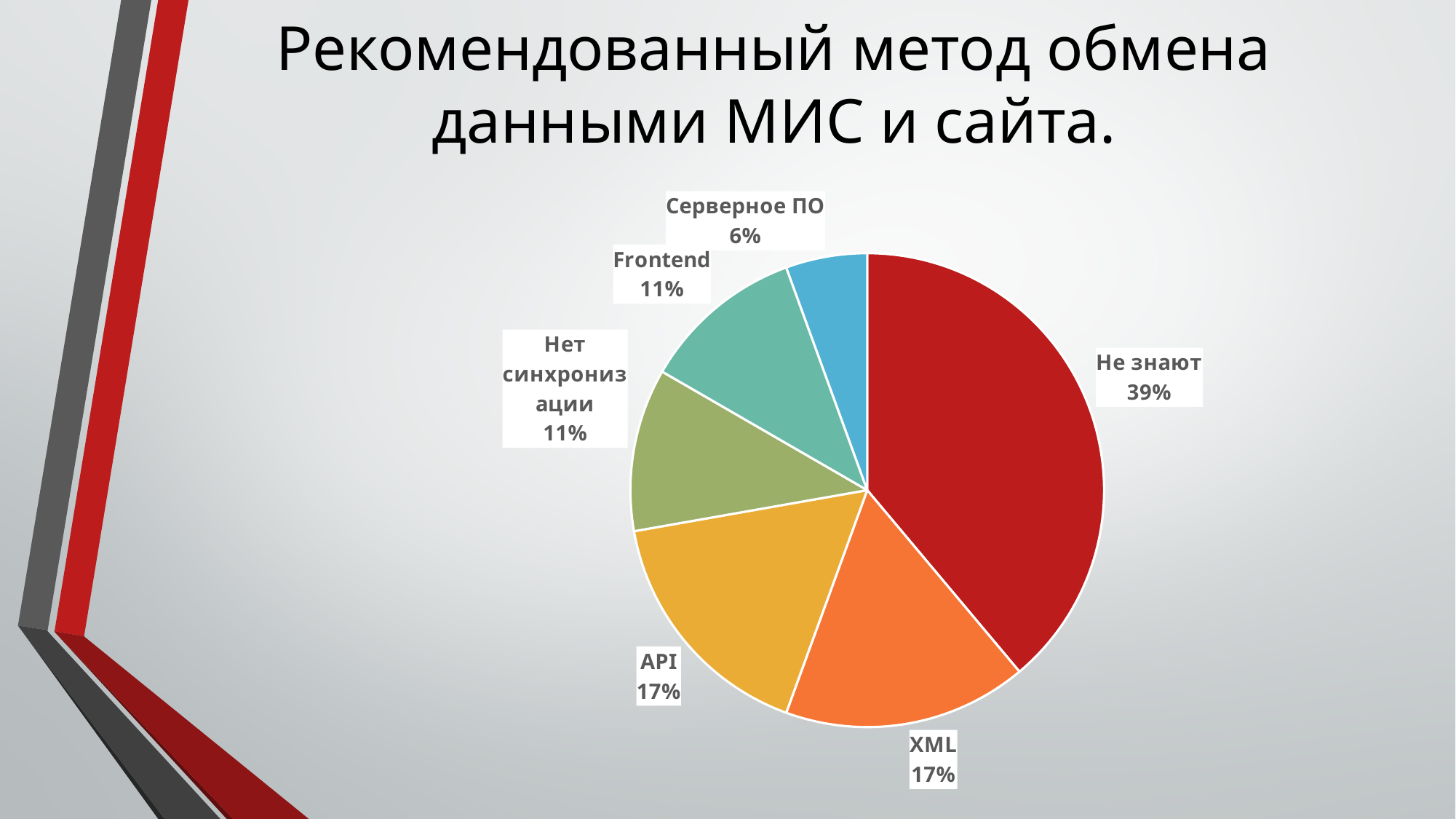
What is the title of the slide containing the chart? Рекомендованный метод обмена данными МИС и сайта. What is the value shown for "Frontend"? 11% How many categories are shown in the pie chart? 6 What is the difference between the shares of "Не знают" and "XML"? 22% Which is larger, the share for "Frontend" or the share for "Серверное ПО"? Frontend What is the value shown for "Серверное ПО"? 6% Which category has the smallest slice of the pie? Серверное ПО What share of the pie does "Не знают" have? 39% What kind of chart is shown on the slide? pie chart Which category has the largest slice of the pie? Не знают What is the value shown for "API"? 17% What is the value shown for "Нет синхронизации"? 11%